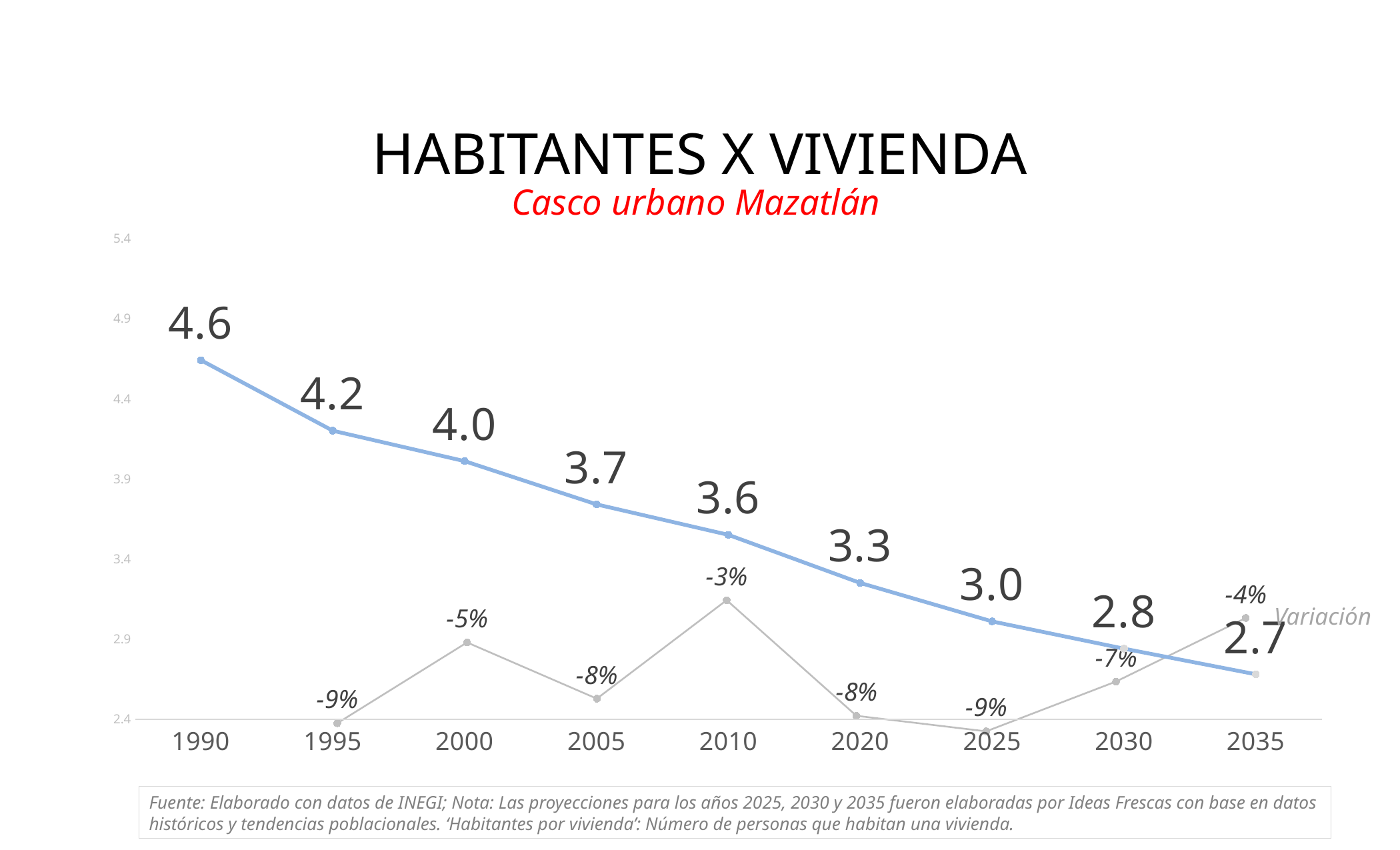
What is the value of habitantes por vivienda for 2020? 3.3 How many years are shown on the x axis? 9 What is the projected value of habitantes por vivienda for 2035? 2.7 Do the habitantes por vivienda values rise or fall from 1990 to 2035? Fall What kind of chart is shown on the slide? Line chart Which year has the highest value of habitantes por vivienda? 1990 Which year has the lowest value of habitantes por vivienda? 2035 What is the Variación value shown for 2010? -3% What is the value of habitantes por vivienda for 1990? 4.6 Which is larger, the habitantes por vivienda value for 2005 or for 2025? 2005 What is the difference between the habitantes por vivienda values for 1990 and 2035? 1.9 What is the Variación value shown for 2025? -9%